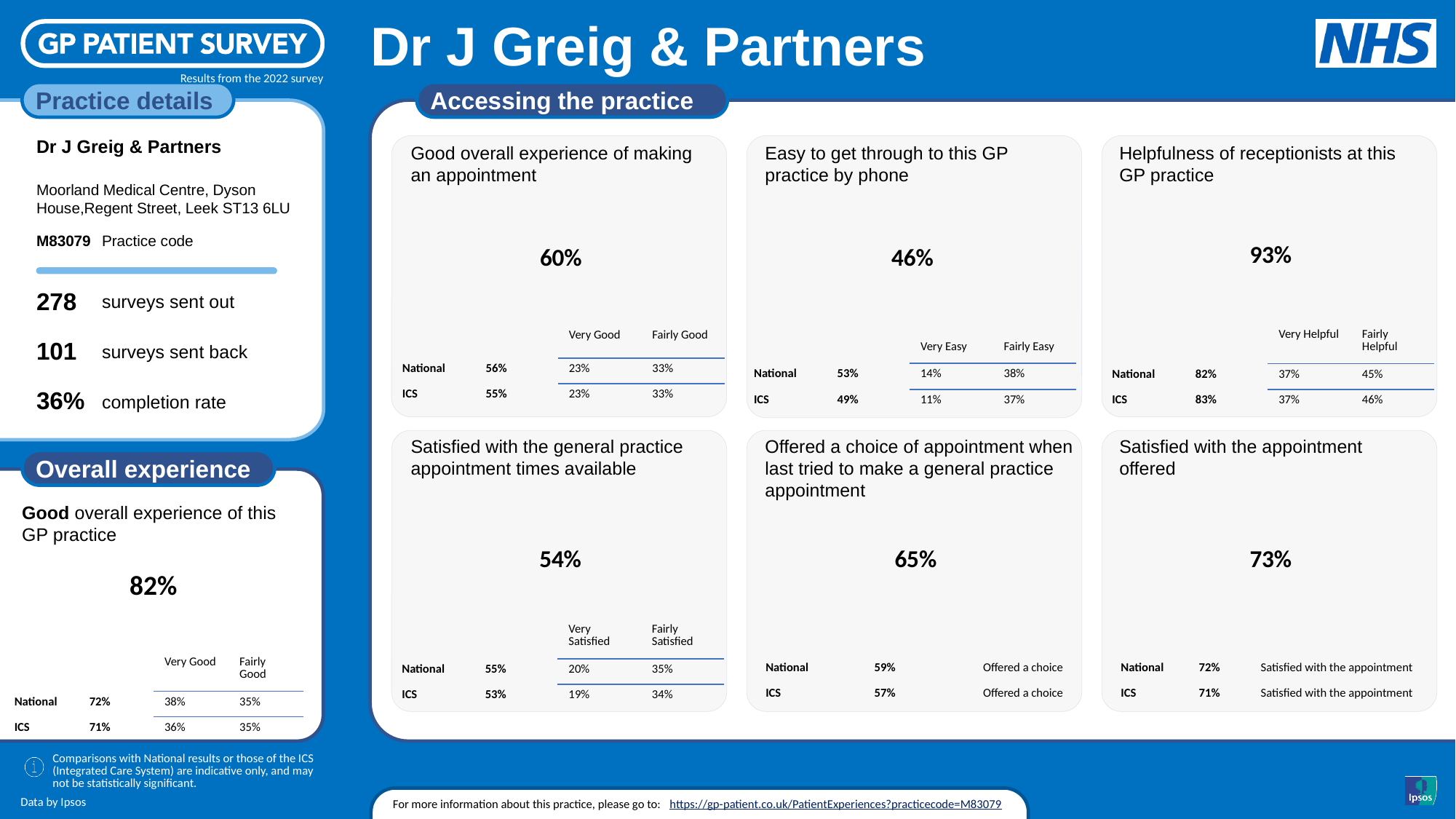
In the 'Satisfied with the general practice appointment times available' panel, what is the practice's percentage? 54% In the 'Easy to get through to this GP practice by phone' panel, what is the National value? 53% In the 'Offered a choice of appointment when last tried to make a general practice appointment' panel, what is the National value? 59% In the 'Easy to get through to this GP practice by phone' panel, what is the difference between the practice's 46% and the National 53%? 7% In the 'Helpfulness of receptionists at this GP practice' panel, is the practice's value higher or lower than the National value? higher Which panel under 'Accessing the practice' shows the highest practice percentage? Helpfulness of receptionists at this GP practice In the 'Satisfied with the appointment offered' panel, what is the difference between the practice's 73% and the ICS 71%? 2% In the 'Helpfulness of receptionists at this GP practice' panel, what is the ICS value? 83% In the 'Satisfied with the appointment offered' panel, what is the ICS value? 71% In the 'Good overall experience of making an appointment' panel, what is the practice's percentage? 60% In the 'Good overall experience of this GP practice' panel, what is the practice's percentage? 82% In the 'Good overall experience of this GP practice' panel, what is the National 'Very Good' value? 38%